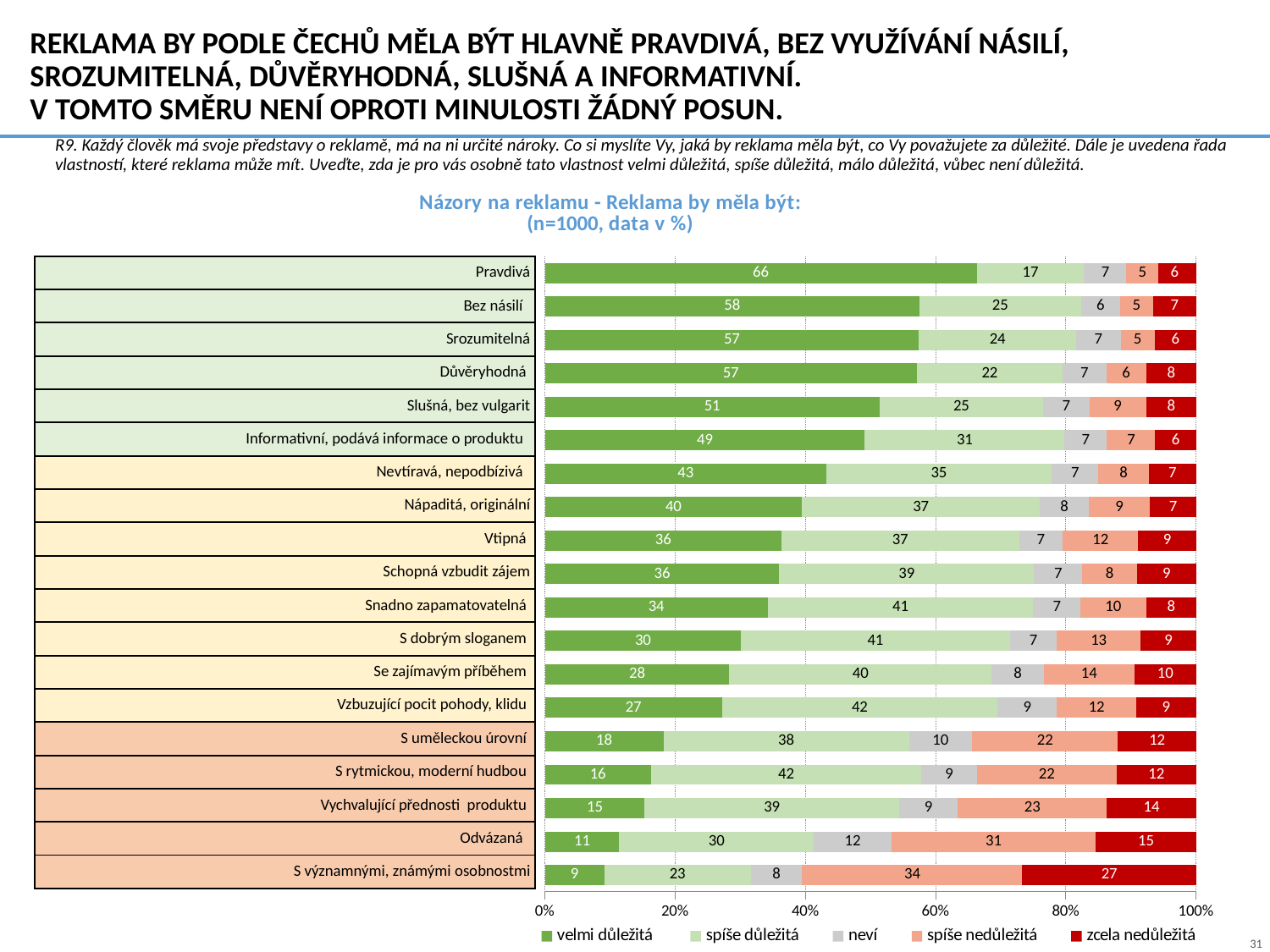
What is the difference between the 'velmi důležitá' values for 'Bez násilí' and 'Odvázaná'? 47 What kind of chart is shown on the slide? stacked bar chart Is the 'velmi důležitá' value for 'Slušná, bez vulgarit' greater or less than 40%? greater What is the 'spíše důležitá' value for 'Vzbuzující pocit pohody, klidu'? 42 Which category has the lowest 'velmi důležitá' value? S významnými, známými osobnostmi Which category has the highest 'velmi důležitá' value? Pravdivá How many series does the legend list? 5 What is the 'velmi důležitá' value for 'Pravdivá'? 66 Which legend entry is shown in dark red? zcela nedůležitá How many categories (attributes) are plotted in the chart? 19 What is the 'zcela nedůležitá' value for 'S významnými, známými osobnostmi'? 27 Which has a larger 'spíše nedůležitá' value: 'Odvázaná' or 'Vtipná'? Odvázaná